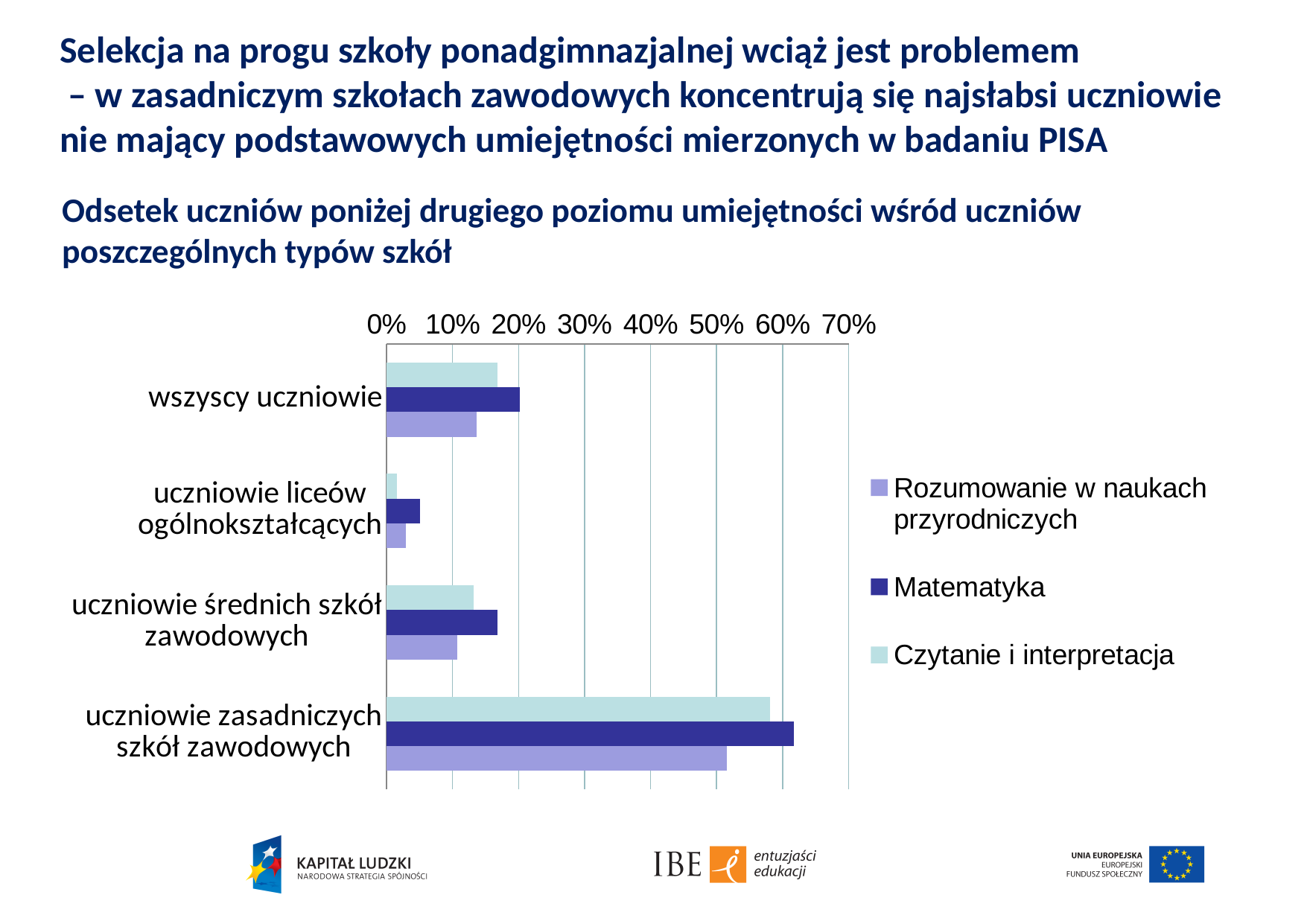
Is the Matematyka value for wszyscy uczniowie greater or less than 30%? less Is the Czytanie i interpretacja value for uczniowie zasadniczych szkół zawodowych greater or less than 50%? greater Is the Matematyka value for uczniowie zasadniczych szkół zawodowych greater or less than 60%? greater How many school-type categories are plotted on the chart? 4 Which category has the lowest value for Czytanie i interpretacja? uczniowie liceów ogólnokształcących What kind of chart is shown on the slide? bar chart Which series is shown in the lightest blue colour in the legend? Czytanie i interpretacja Which category has the highest value for Matematyka? uczniowie zasadniczych szkół zawodowych How many series does the legend list? 3 For uczniowie zasadniczych szkół zawodowych, which is larger: the Matematyka value or the Rozumowanie w naukach przyrodniczych value? Matematyka Which is larger: the Matematyka value for wszyscy uczniowie or the Matematyka value for uczniowie liceów ogólnokształcących? wszyscy uczniowie